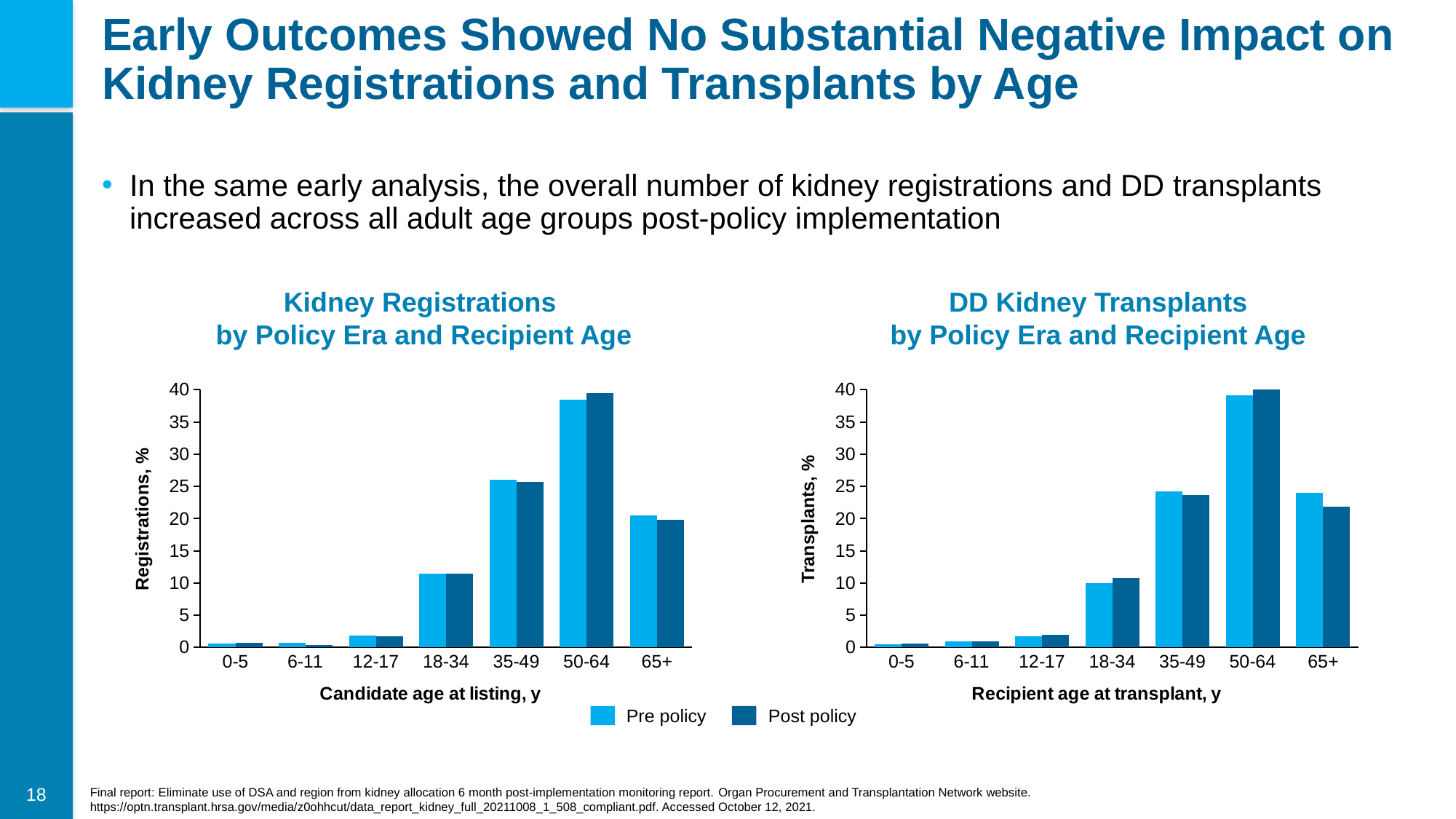
In the DD Kidney Transplants by Policy Era and Recipient Age chart, which age group has the highest Post policy value? 50-64 In the DD Kidney Transplants by Policy Era and Recipient Age chart, is the Post policy value for 50-64 greater or less than 35? greater How many series does the legend list for the charts on the slide? 2 In the Kidney Registrations by Policy Era and Recipient Age chart, is the Pre policy value for 35-49 greater or less than 20? greater In the DD Kidney Transplants by Policy Era and Recipient Age chart, which is larger for the 65+ group, Pre policy or Post policy? Pre policy How many age categories are shown on the x axis of the Kidney Registrations by Policy Era and Recipient Age chart? 7 In the Kidney Registrations by Policy Era and Recipient Age chart, is the Pre policy value for 18-34 greater or less than 10? greater In the DD Kidney Transplants by Policy Era and Recipient Age chart, which age group has the lowest Pre policy value? 0-5 What kind of chart is the Kidney Registrations by Policy Era and Recipient Age chart? bar chart In the Kidney Registrations by Policy Era and Recipient Age chart, which age group has the highest Pre policy value? 50-64 What is the x-axis title of the Kidney Registrations by Policy Era and Recipient Age chart? Candidate age at listing, y